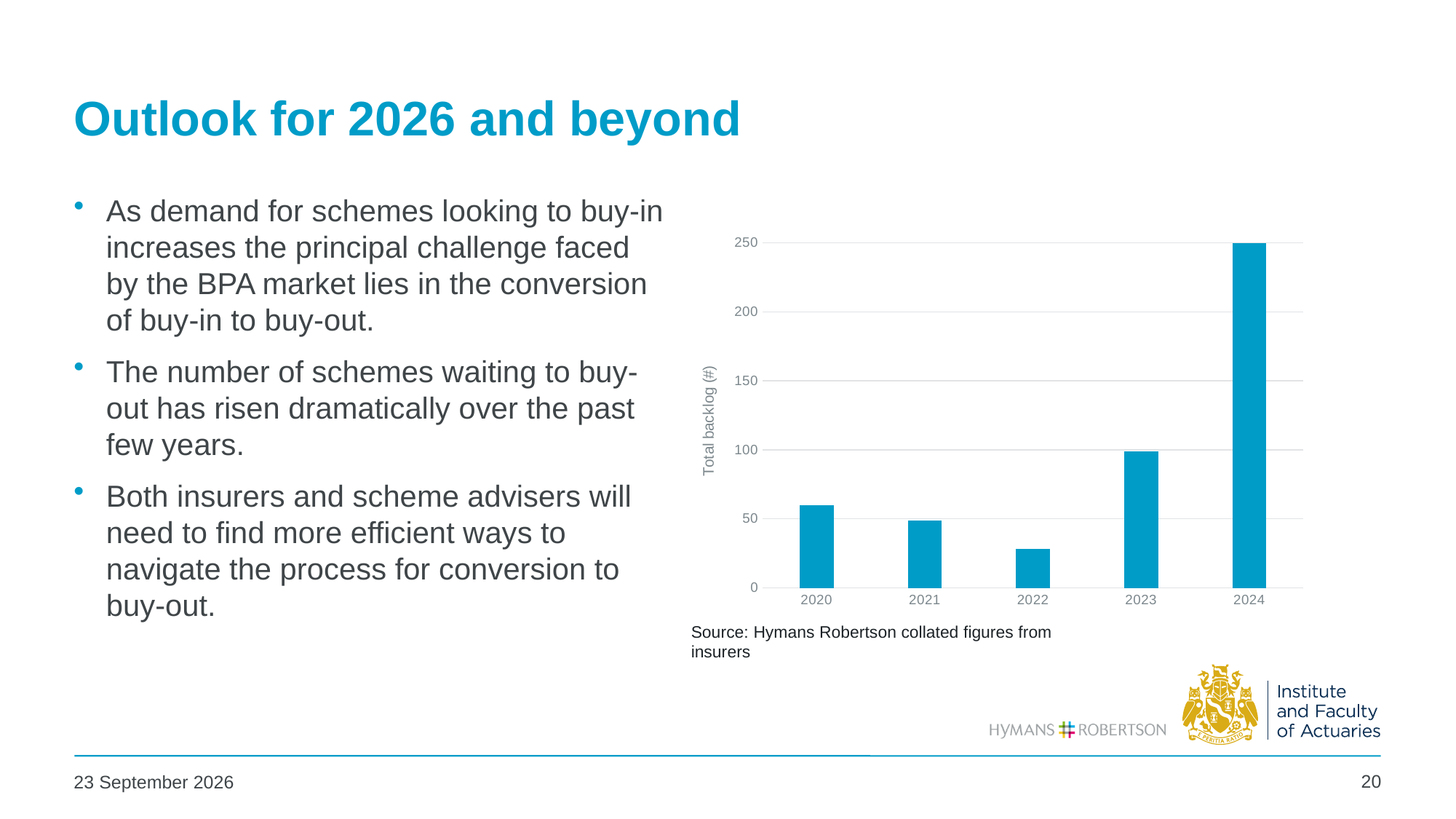
Which year has the lowest total backlog? 2022 Is the value for 2022 greater or less than 50? less Which is larger, the value for 2023 or the value for 2020? 2023 Is the value for 2023 greater or less than 50? greater Which is larger, the value for 2020 or the value for 2022? 2020 What is the label on the y axis of the chart? Total backlog (#) What kind of chart is shown on the slide? bar chart How many years are shown on the x axis of the chart? 5 Which year has the highest total backlog? 2024 Do the values rise or fall from 2022 to 2024? rise Is the value for 2024 greater or less than 200? greater